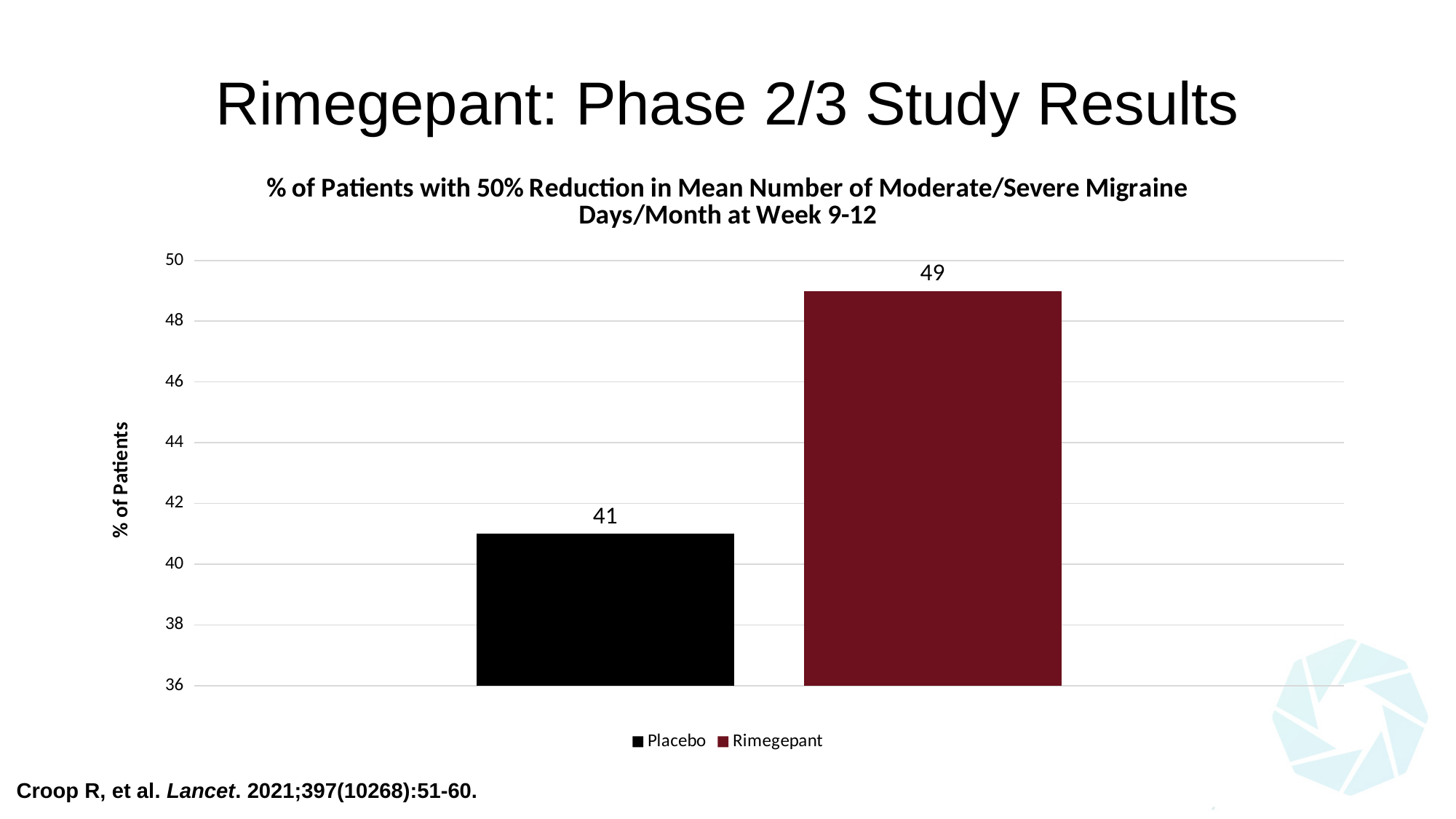
What is the difference between the Rimegepant and Placebo values? 8 Which is larger, the value for Placebo or the value for Rimegepant? Rimegepant How many series does the legend list? 2 What is the value for Placebo? 41 Which series has the lowest value? Placebo Is the value for Placebo greater or less than 40? greater What is the value for Rimegepant? 49 What kind of chart is shown on the slide? Bar chart Which series has the highest value? Rimegepant Is the value for Rimegepant greater or less than 50? less What is the label of the y axis? % of Patients How many bars are plotted in the chart? 2